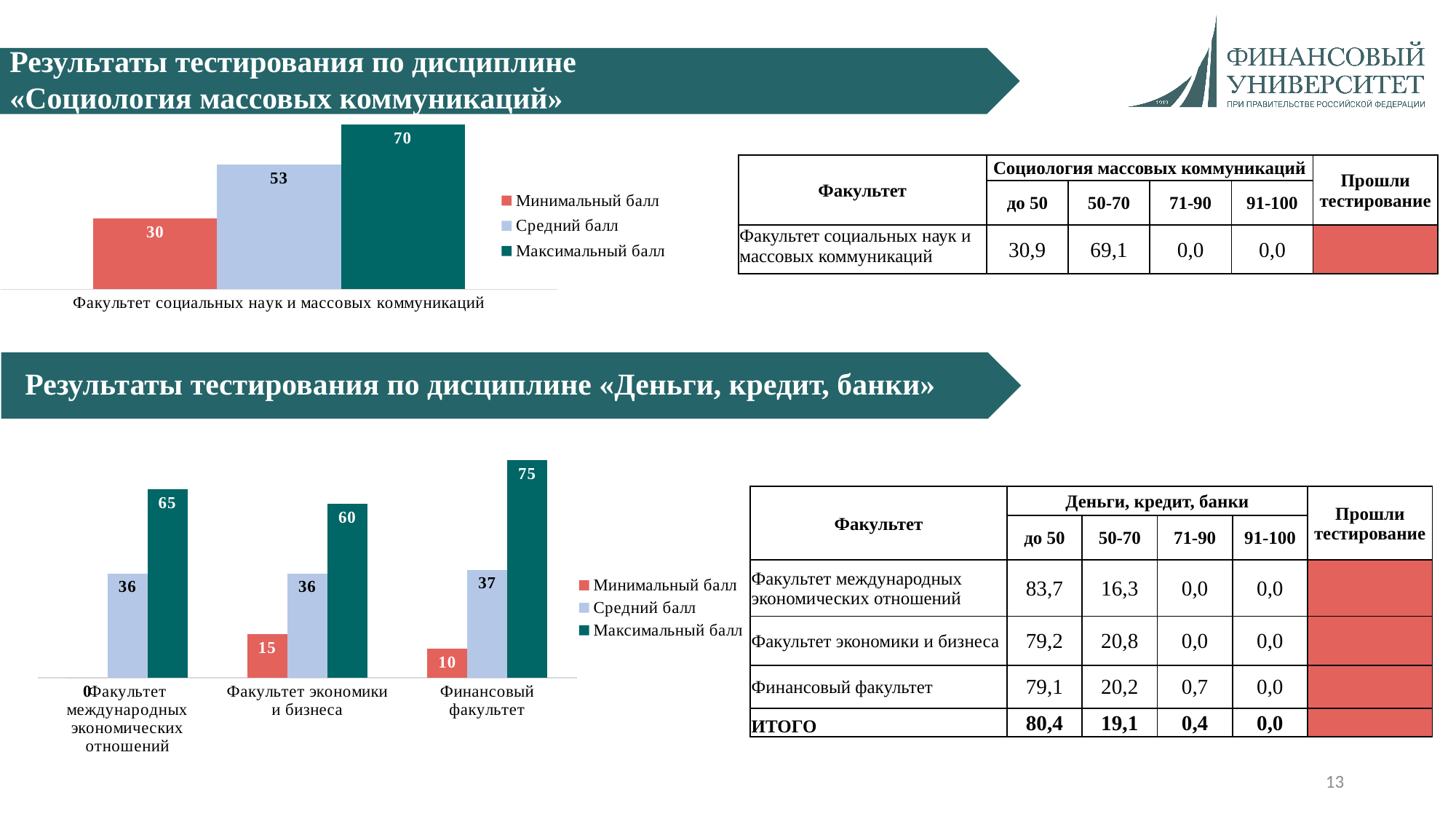
In the top chart (Социология массовых коммуникаций), what is the value of Максимальный балл? 70 In the top chart (Социология массовых коммуникаций), what is the value of Средний балл? 53 In the bottom chart (Деньги, кредит, банки), what is the Максимальный балл for Финансовый факультет? 75 In the bottom chart (Деньги, кредит, банки), how many faculties are shown on the x axis? 3 In the bottom chart (Деньги, кредит, банки), what is the Минимальный балл for Факультет экономики и бизнеса? 15 In the bottom chart (Деньги, кредит, банки), is the Максимальный балл larger for Факультет международных экономических отношений or for Факультет экономики и бизнеса? Факультет международных экономических отношений In the bottom chart (Деньги, кредит, банки), what is the difference between Максимальный балл and Средний балл for Финансовый факультет? 38 In the bottom chart (Деньги, кредит, банки), which faculty has the lowest Минимальный балл? Факультет международных экономических отношений How many series does the legend of the top chart list? 3 In the top chart (Социология массовых коммуникаций), what is the difference between Максимальный балл and Минимальный балл? 40 In the bottom chart (Деньги, кредит, банки), which faculty has the highest Максимальный балл? Финансовый факультет What kind of chart is the bottom chart (Деньги, кредит, банки)? bar chart